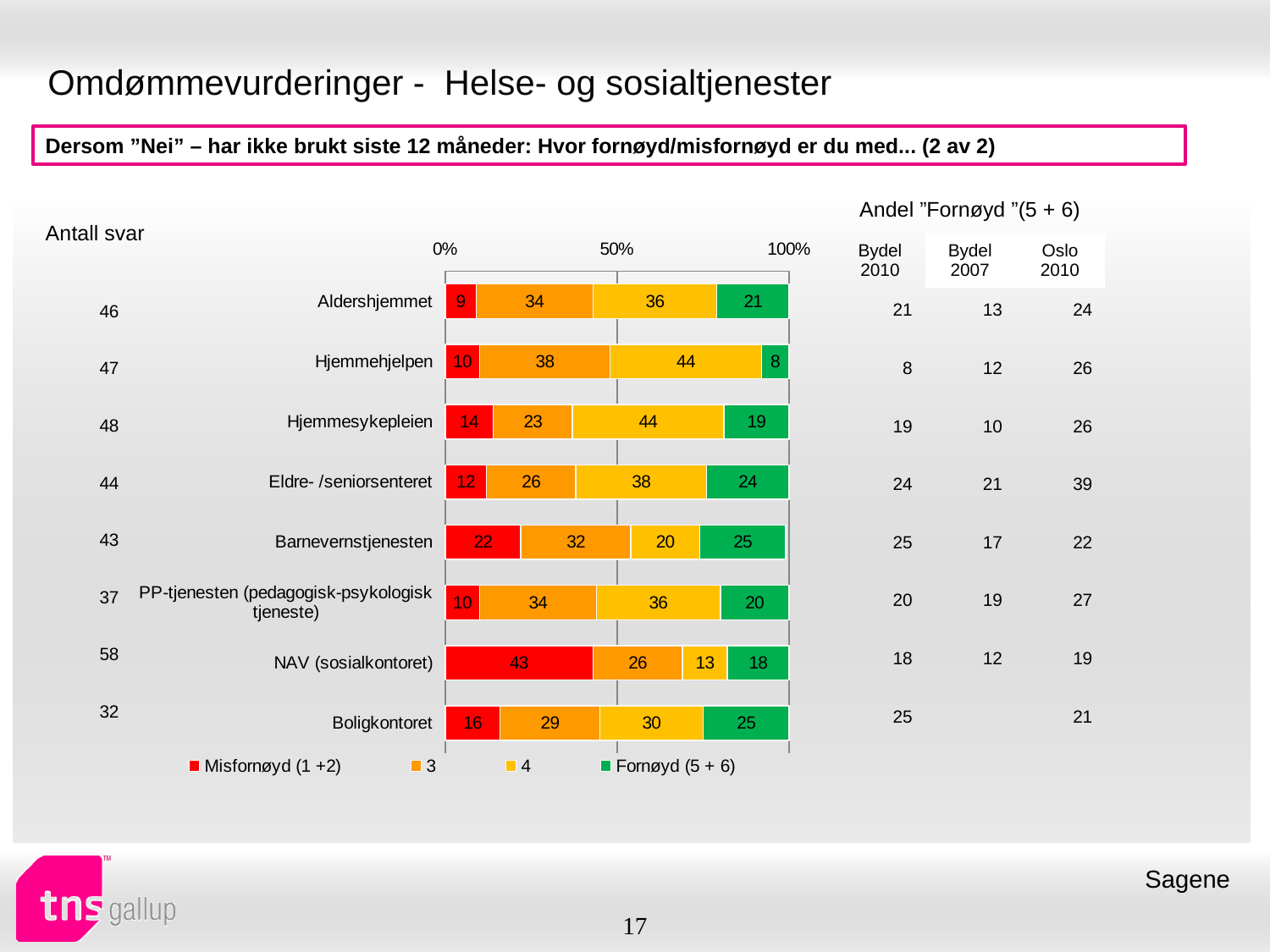
What kind of chart is shown on the slide? Stacked bar chart What is the value of the Fornøyd (5 + 6) segment for Hjemmehjelpen? 8 How many series does the legend list? 4 What is the value of the '4' segment for Hjemmesykepleien? 44 What is the total of the stacked bar for Aldershjemmet? 100 How many categories are shown in the bar chart? 8 What is the difference between the Fornøyd (5 + 6) values for Boligkontoret and Aldershjemmet? 4 What is the value of the Misfornøyd (1 +2) segment for NAV (sosialkontoret)? 43 Which has the larger Misfornøyd (1 +2) value, Barnevernstjenesten or Boligkontoret? Barnevernstjenesten What is the first entry in the chart legend? Misfornøyd (1 +2) Which category has the lowest Fornøyd (5 + 6) value? Hjemmehjelpen Which category has the highest Misfornøyd (1 +2) value? NAV (sosialkontoret)